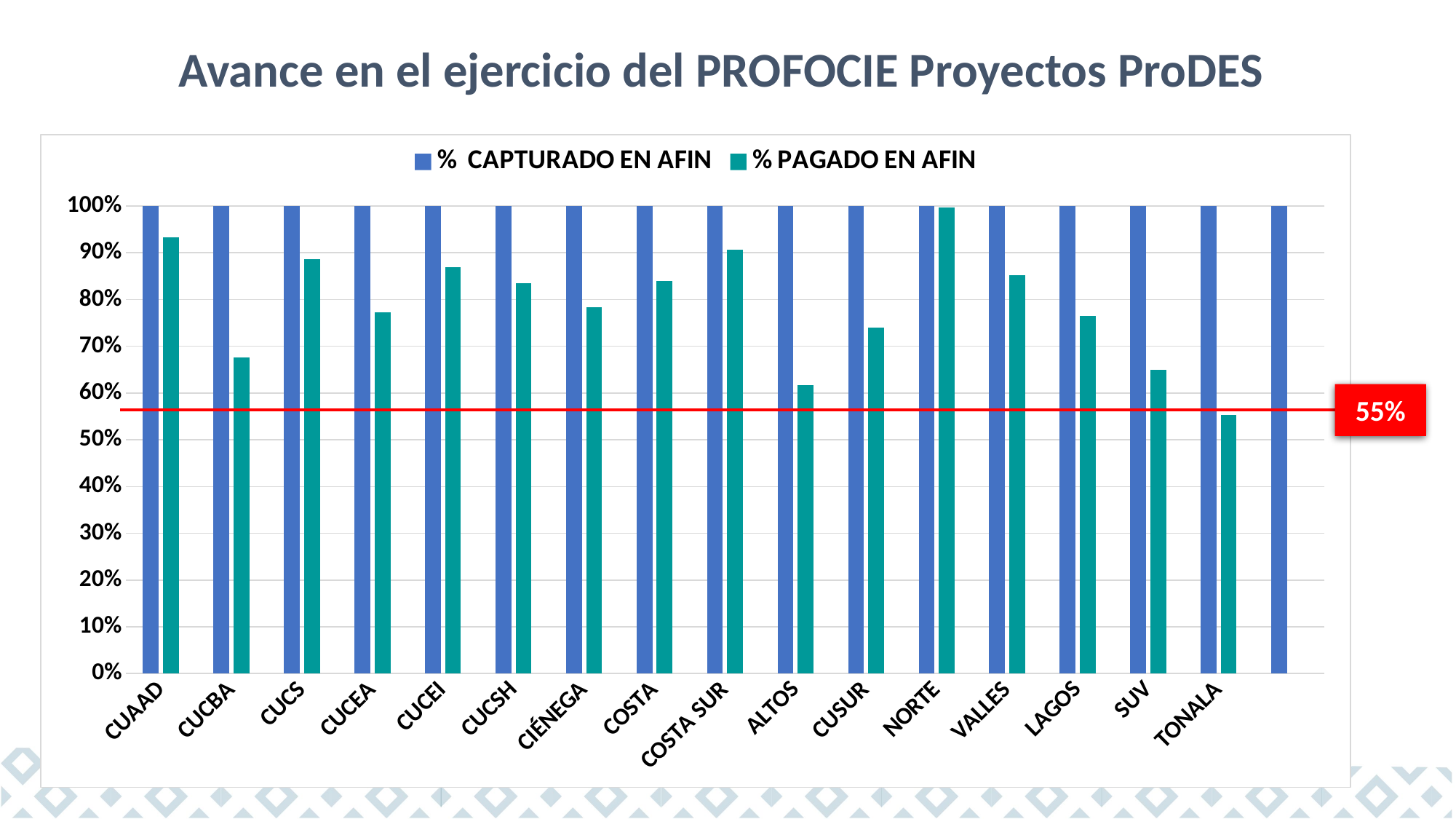
What kind of chart is shown on the slide? bar chart What is the value of % CAPTURADO EN AFIN for CUAAD? 100% What is the title of the chart? Avance en el ejercicio del PROFOCIE Proyectos ProDES Which has a larger % PAGADO EN AFIN, CUAAD or CUCBA? CUAAD What is the value of % CAPTURADO EN AFIN for TONALA? 100% Which category has the highest % PAGADO EN AFIN? NORTE Is the % PAGADO EN AFIN for TONALA greater or less than 60%? less Which labeled category has the lowest % PAGADO EN AFIN? TONALA How many series does the legend list? 2 Is the % PAGADO EN AFIN for SUV greater or less than 70%? less Is the % PAGADO EN AFIN for CUAAD greater or less than 90%? greater What value is labeled on the red horizontal line across the chart? 55%